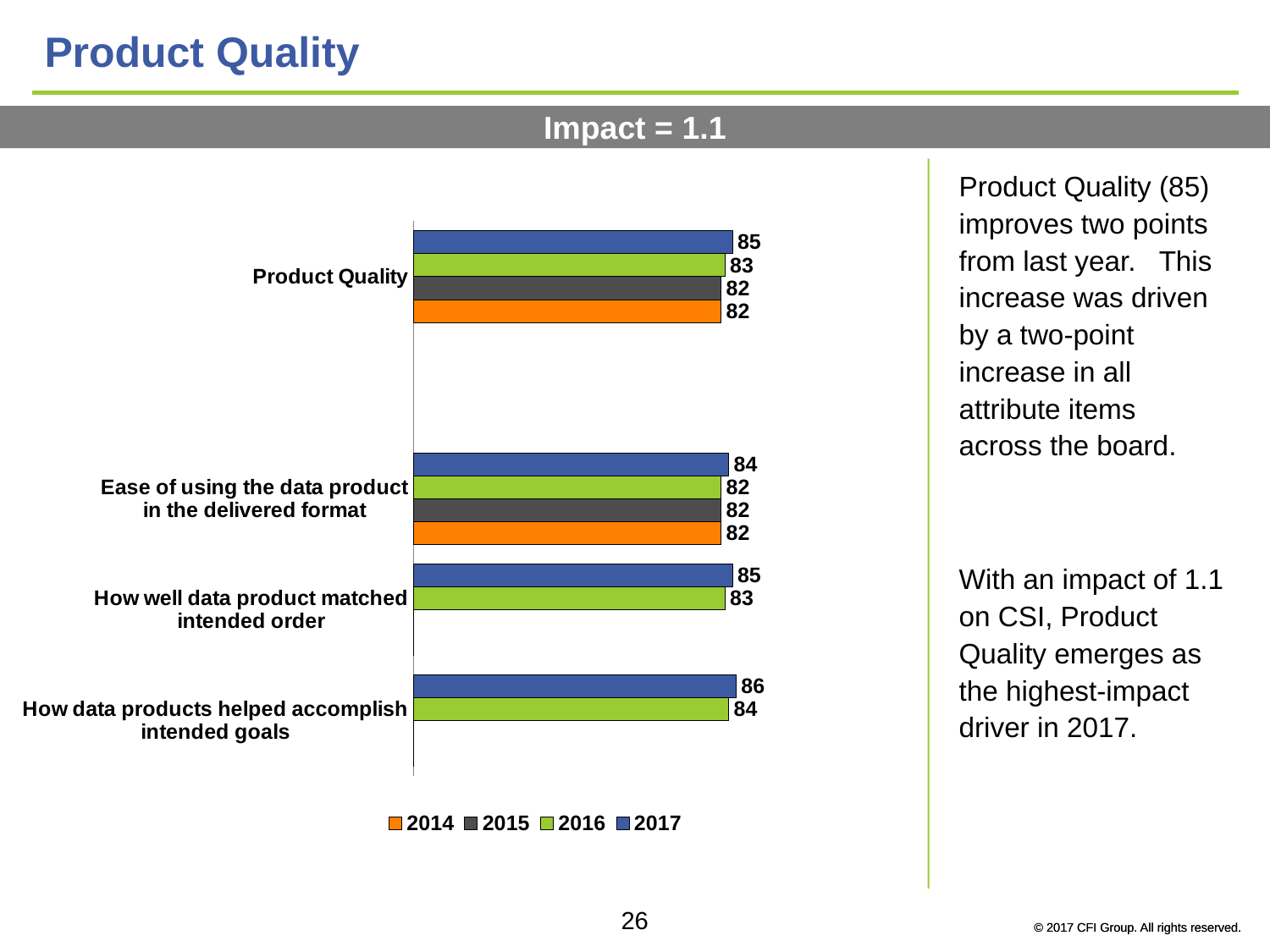
What kind of chart is shown on the slide? Bar chart How many series does the legend list? 4 What is the 2017 value for Product Quality? 85 What is the difference between the 2017 and 2016 values for Product Quality? 2 What is the 2017 value for How data products helped accomplish intended goals? 86 Which colour represents 2014 in the legend? Orange Which category has the lowest 2017 value? Ease of using the data product in the delivered format Which category has the highest 2017 value? How data products helped accomplish intended goals What is the 2014 value for Product Quality? 82 How many categories are shown on the chart? 4 Which is larger for How well data product matched intended order: the 2017 value or the 2016 value? 2017 What is the 2016 value for Ease of using the data product in the delivered format? 82